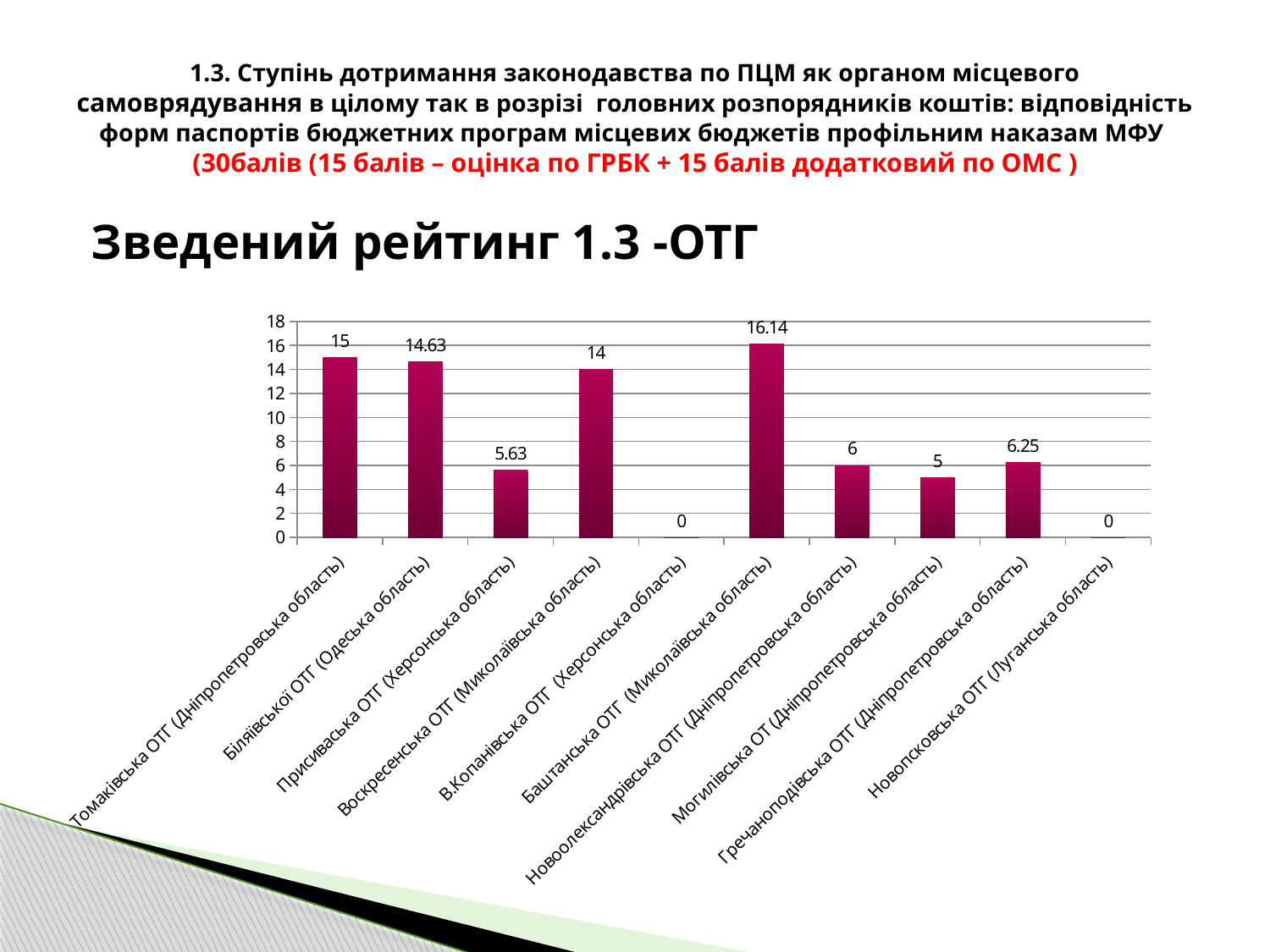
What kind of chart is shown on the slide? bar chart What is the difference between the values for Біляївської ОТГ (Одеська область) and Воскресенська ОТГ (Миколаївська область)? 0.63 What is the value for Гречанопідівська ОТГ (Дніпропетровська область)? 6.25 What is the value for Біляївської ОТГ (Одеська область)? 14.63 What is the difference between the values for Баштанська ОТГ (Миколаївська область) and Томаківська ОТГ (Дніпропетровська область)? 1.14 What is the value for Томаківська ОТГ (Дніпропетровська область)? 15 Which category has the highest value? Баштанська ОТГ (Миколаївська область) Is the value for Воскресенська ОТГ (Миколаївська область) greater or less than 10? greater What is the title of the chart? Зведений рейтинг 1.3 -ОТГ How many categories are shown on the chart? 10 Which is larger: the value for Присиваська ОТГ (Херсонська область) or Могилівська ОТ (Дніпропетровська область)? Присиваська ОТГ (Херсонська область) What is the value for Присиваська ОТГ (Херсонська область)? 5.63